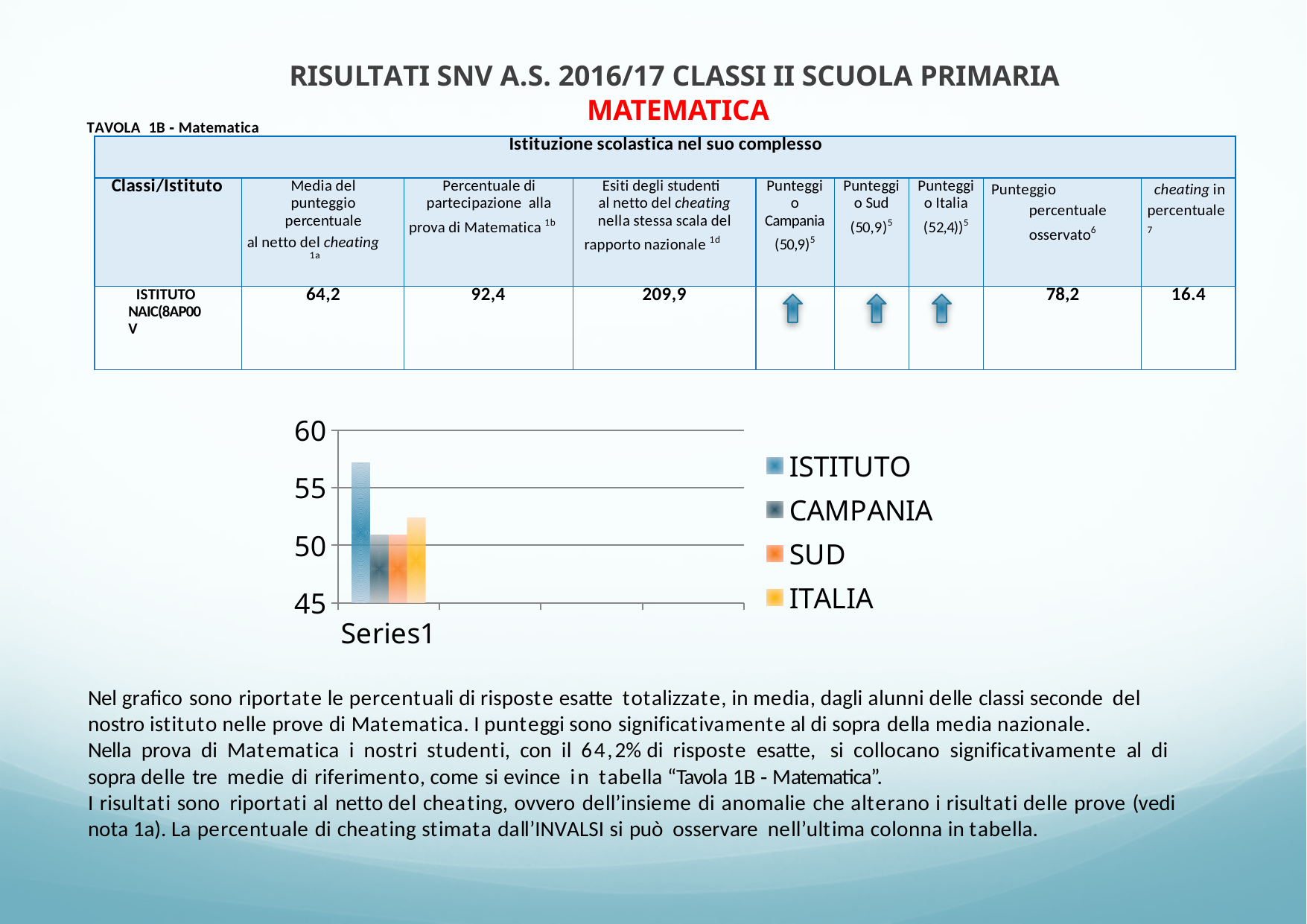
Is the value for ISTITUTO in the chart greater or less than 55? greater What kind of chart is shown on the slide? bar chart Is the value for CAMPANIA in the chart greater or less than 55? less Is the value for ISTITUTO in the chart greater or less than 60? less How many series does the chart legend list? 4 Which is larger in the chart, the bar for ISTITUTO or the bar for ITALIA? ISTITUTO What is the label shown on the x axis of the chart? Series1 Which series has the tallest bar in the chart? ISTITUTO Which series is shown in orange in the chart legend? SUD Which is larger in the chart, the bar for ITALIA or the bar for CAMPANIA? ITALIA